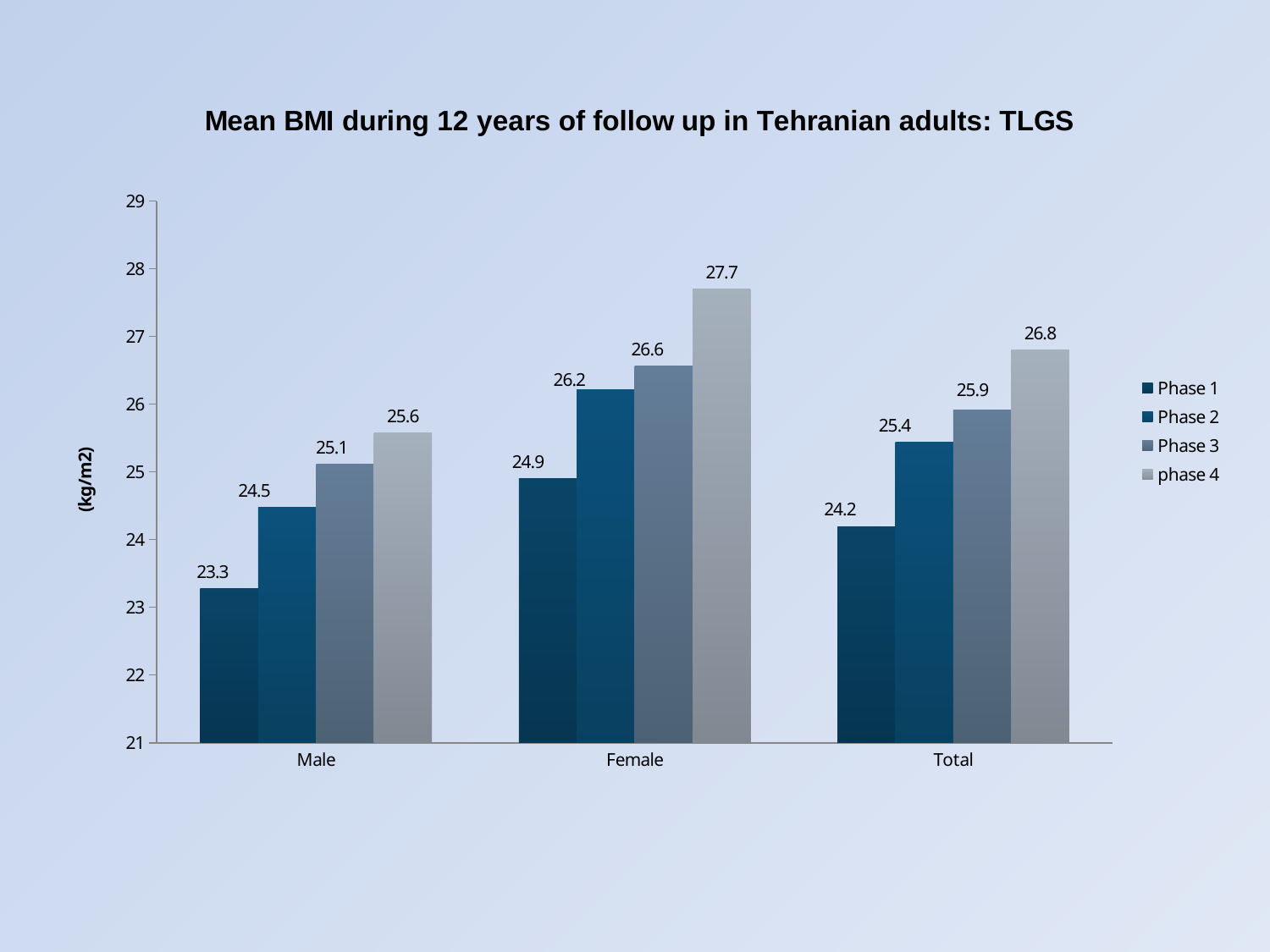
What is the difference between the Female and Male values in phase 4? 2.1 Which is larger: the Male Phase 3 value or the Total Phase 2 value? Total Phase 2 Which category has the highest Phase 2 value? Female What is the label on the vertical axis? (kg/m2) What is the mean BMI for Female in phase 4? 27.7 How many series does the legend list? 4 Which category has the lowest phase 4 value? Male What kind of chart is shown? bar chart Is the Female Phase 3 value greater or less than 26? greater What is the mean BMI for Male in Phase 1? 23.3 What is the mean BMI for Total in Phase 3? 25.9 How many categories are shown on the x axis? 3